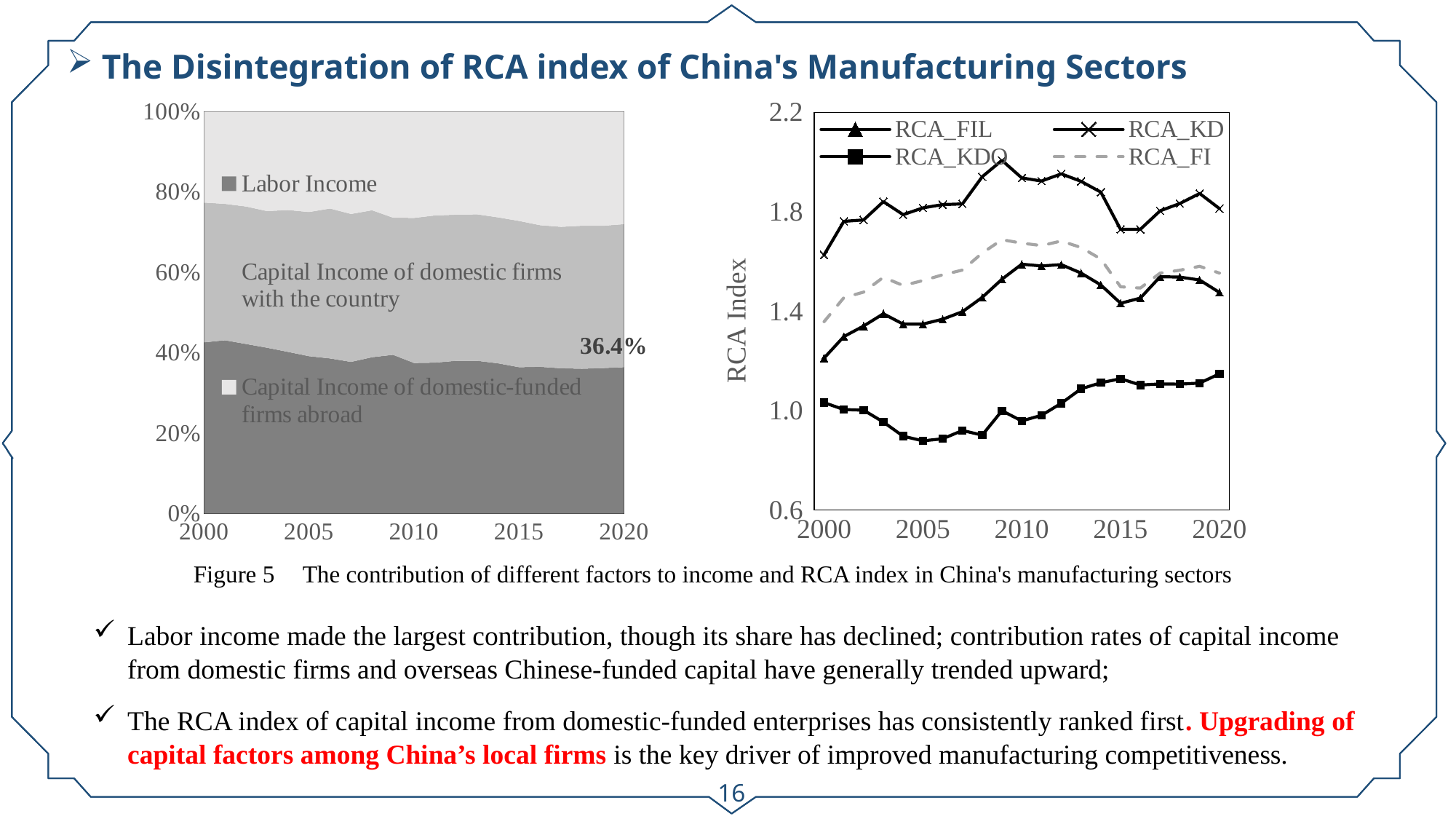
What kind of chart is the chart on the right of the slide? line chart What is the y-axis title of the right-hand chart? RCA Index On the right-hand chart, which series has the lowest values across the whole period? RCA_KDO What kind of chart is the chart on the left of the slide? stacked area chart How many series does the legend of the right-hand chart list? 4 On the right-hand chart, which series has the highest values across the whole period? RCA_KD What data label is printed near 2020 on the left-hand chart? 36.4% On the right-hand chart, is the value of RCA_FIL in 2000 greater or less than 1.4? less On the right-hand chart, which is larger in 2010: RCA_KD or RCA_KDO? RCA_KD On the right-hand chart, is the value of RCA_KDO in 2005 greater or less than 1.0? less On the right-hand chart, does RCA_FIL rise or fall between 2000 and 2010? rise On the right-hand chart, is the value of RCA_KD in 2009 greater or less than 1.8? greater